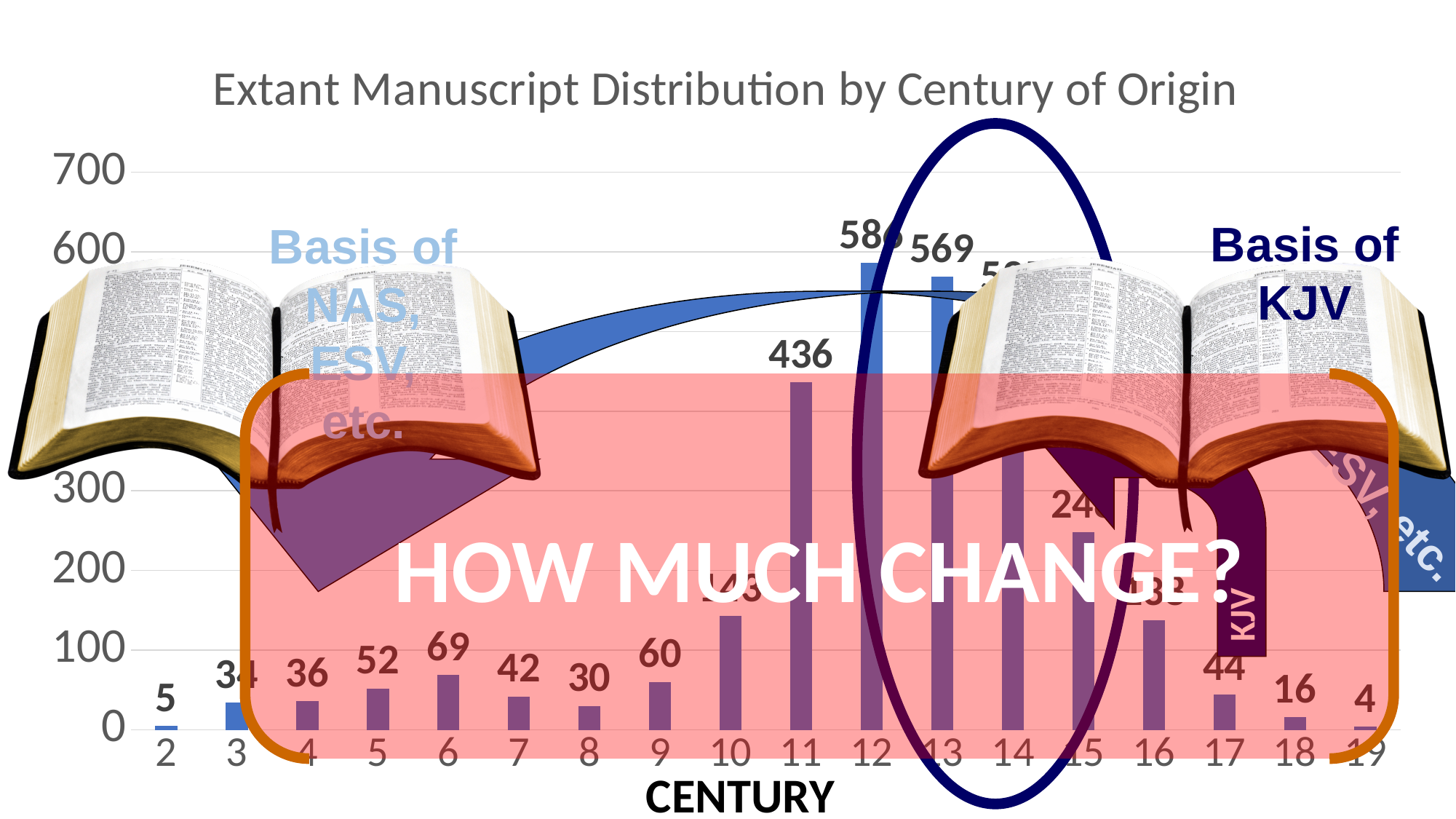
What kind of chart is shown on the slide? bar chart What is the value for century 6? 69 Which has a larger value, century 6 or century 9? century 6 Do the values rise or fall from century 16 to century 19? fall Is the value for century 14 greater or less than 400? greater How many centuries are shown on the x axis? 18 What is the difference between the values for century 13 and century 11? 133 What is the value for century 13? 569 What is the value for century 18? 16 What is the title of the chart? Extant Manuscript Distribution by Century of Origin What is the difference between the values for century 17 and century 18? 28 What is the value for century 11? 436